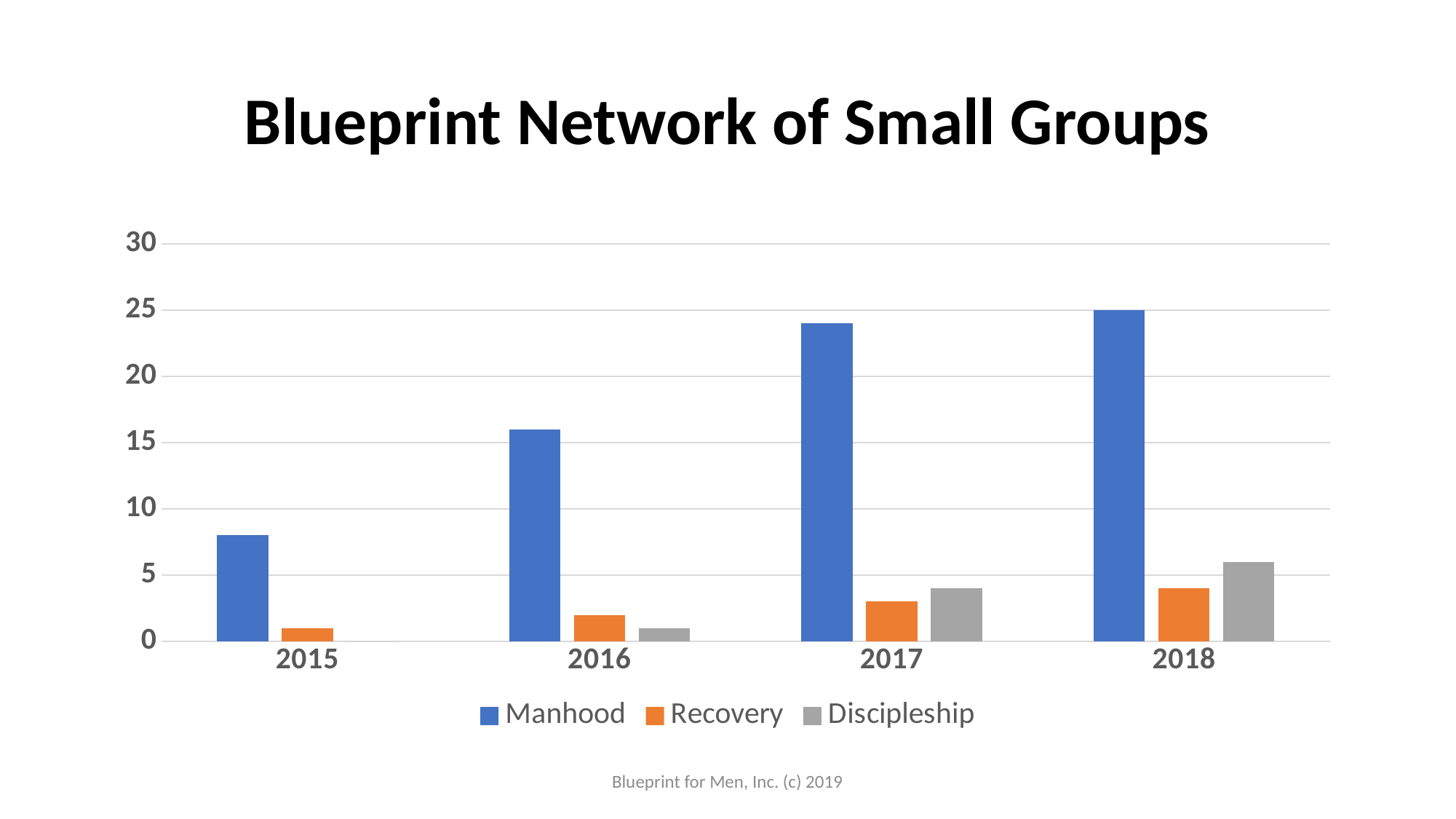
Which is larger in 2016, Manhood or Recovery? Manhood Which year has the lowest value for Manhood? 2015 How many series does the legend list? 3 Do the Manhood values rise or fall from 2015 to 2018? rise Is the value for Manhood in 2015 greater or less than 10? less Is the value for Recovery in 2018 greater or less than 5? less What kind of chart is shown on the slide? bar chart Which year has the highest value for Discipleship? 2018 Which is larger in 2017, Recovery or Discipleship? Discipleship Is the value for Manhood in 2017 greater or less than 20? greater Which series is shown in orange? Recovery How many years are shown on the x axis? 4